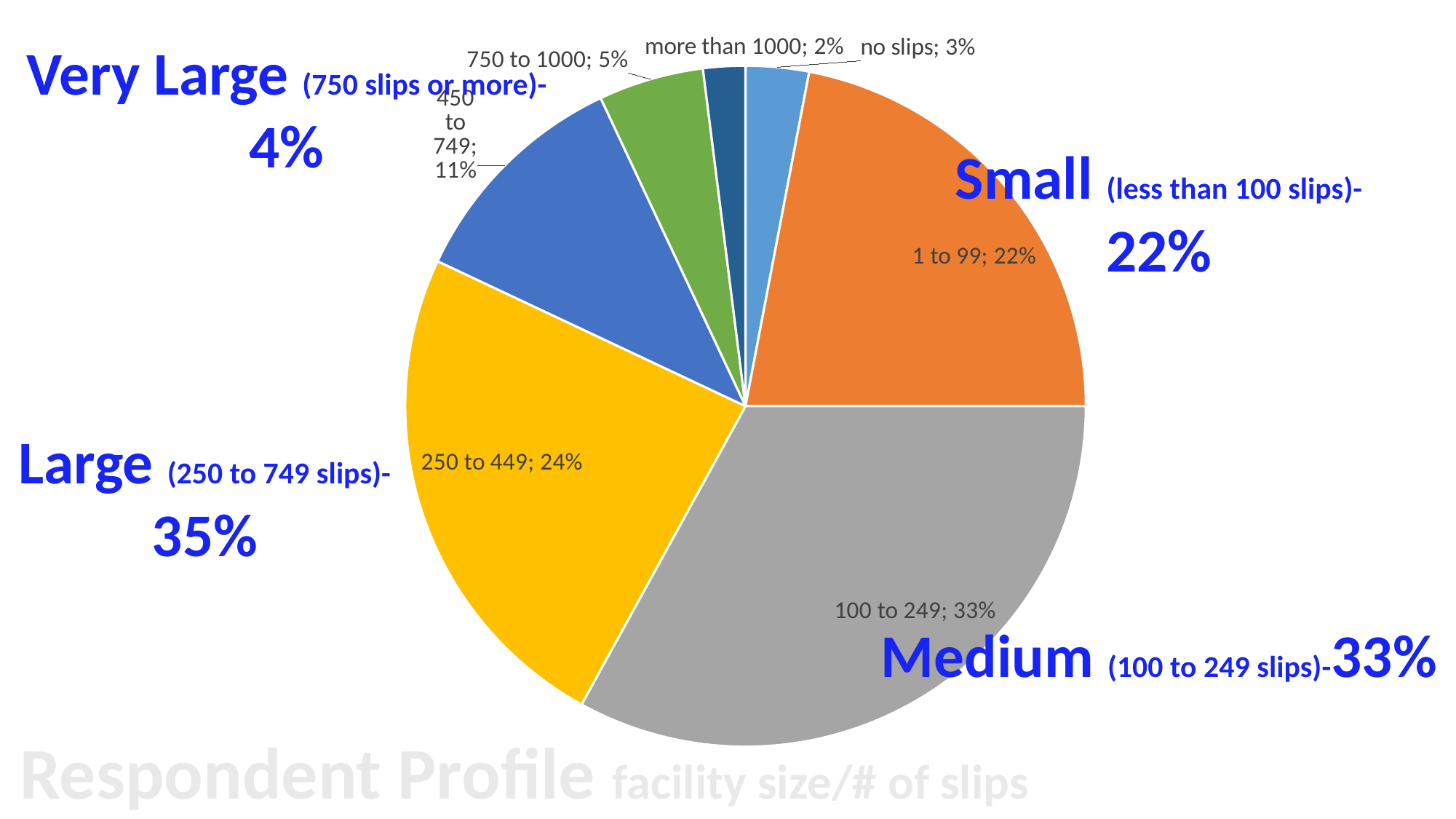
How many slices does the pie chart have? 7 What colour is the "100 to 249" slice? grey Which is larger, the "1 to 99" slice or the "250 to 449" slice? 250 to 449 What share of the pie does the "450 to 749" slice represent? 11% What share of the pie does the "100 to 249" slice represent? 33% Which slice of the pie is the largest? 100 to 249 What is the difference in percentage points between the "250 to 449" slice and the "750 to 1000" slice? 19 What share of the pie does the "more than 1000" slice represent? 2% Which slice of the pie is the smallest? more than 1000 What kind of chart is shown on the slide? pie chart